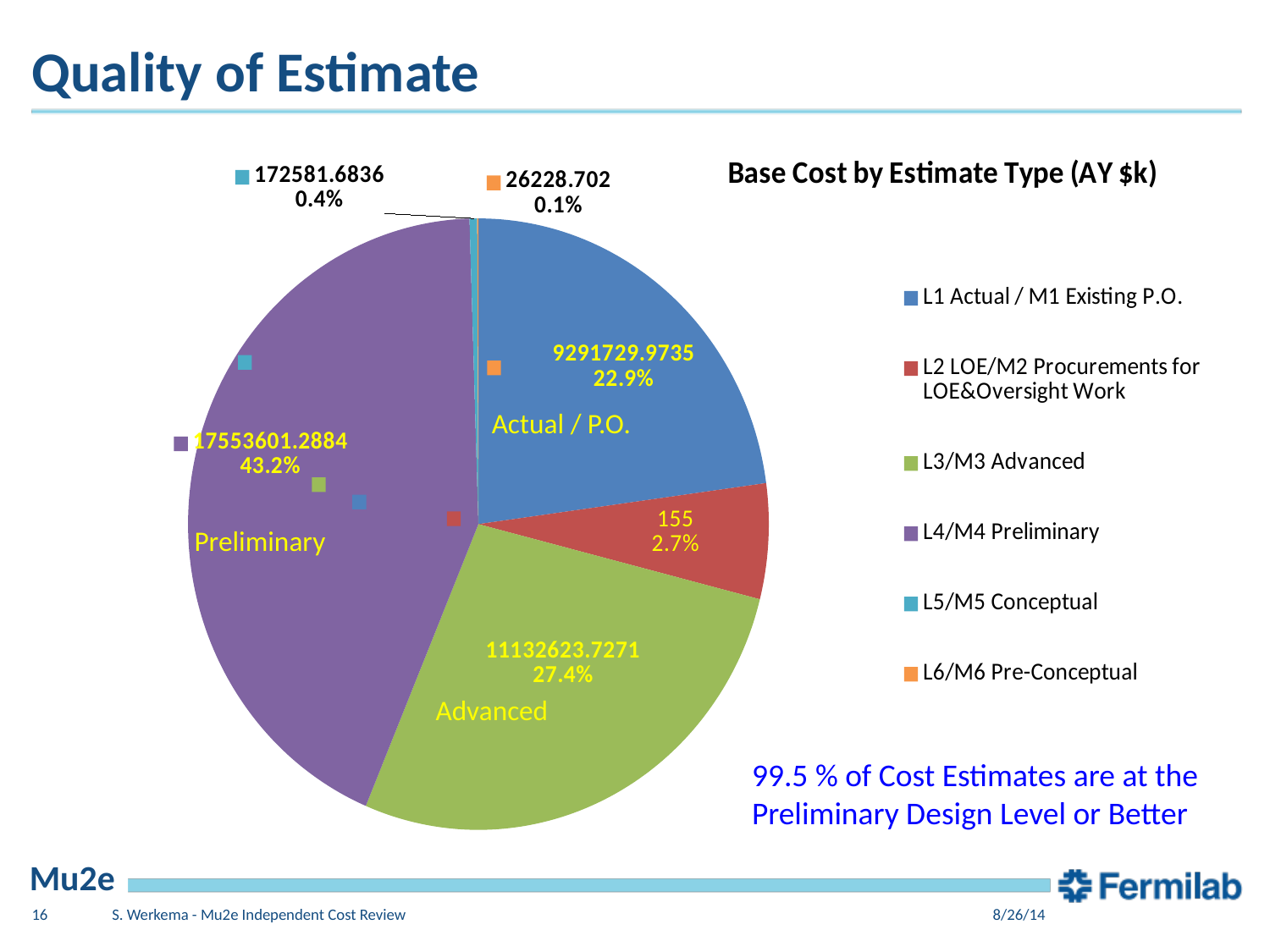
Which is larger, the slice for L1 Actual / M1 Existing P.O. or the slice for L3/M3 Advanced? L3/M3 Advanced How many categories does the legend of the pie chart list? 6 What share of the pie does L3/M3 Advanced represent? 27.4% What share of the pie does L4/M4 Preliminary represent? 43.2% What type of chart is shown on the slide? pie chart Which estimate type has the smallest slice of the pie? L6/M6 Pre-Conceptual What is the title of the chart? Base Cost by Estimate Type (AY $k) Which estimate type has the largest slice of the pie? L4/M4 Preliminary What is the value shown for L5/M5 Conceptual? 172581.6836 What is the value shown for L4/M4 Preliminary? 17553601.2884 What share of the pie does L1 Actual / M1 Existing P.O. represent? 22.9% What is the value shown for L3/M3 Advanced? 11132623.7271